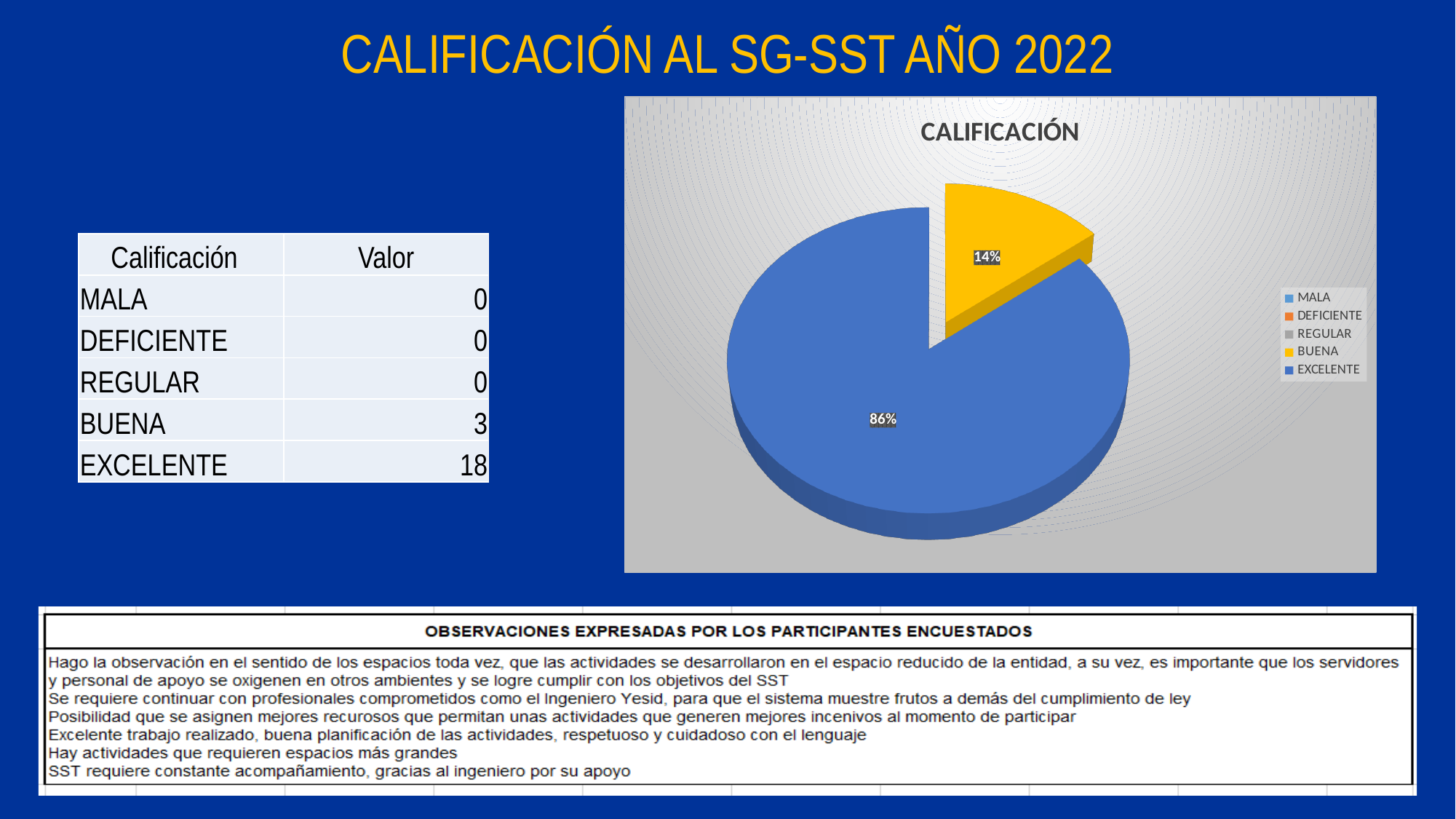
What is the difference in percentage points between the EXCELENTE slice and the BUENA slice? 72% How many slices are visible in the pie chart? 2 What kind of chart is shown on the slide? pie chart Which category has the largest slice of the pie? EXCELENTE What is the title of the chart? CALIFICACIÓN Which slice is larger, BUENA or EXCELENTE? EXCELENTE How many entries does the chart legend list? 5 What share of the pie does the BUENA slice represent? 14% What share of the pie does the EXCELENTE slice represent? 86% What colour is the EXCELENTE slice in the pie chart? blue Is the share for EXCELENTE greater or less than 50%? greater